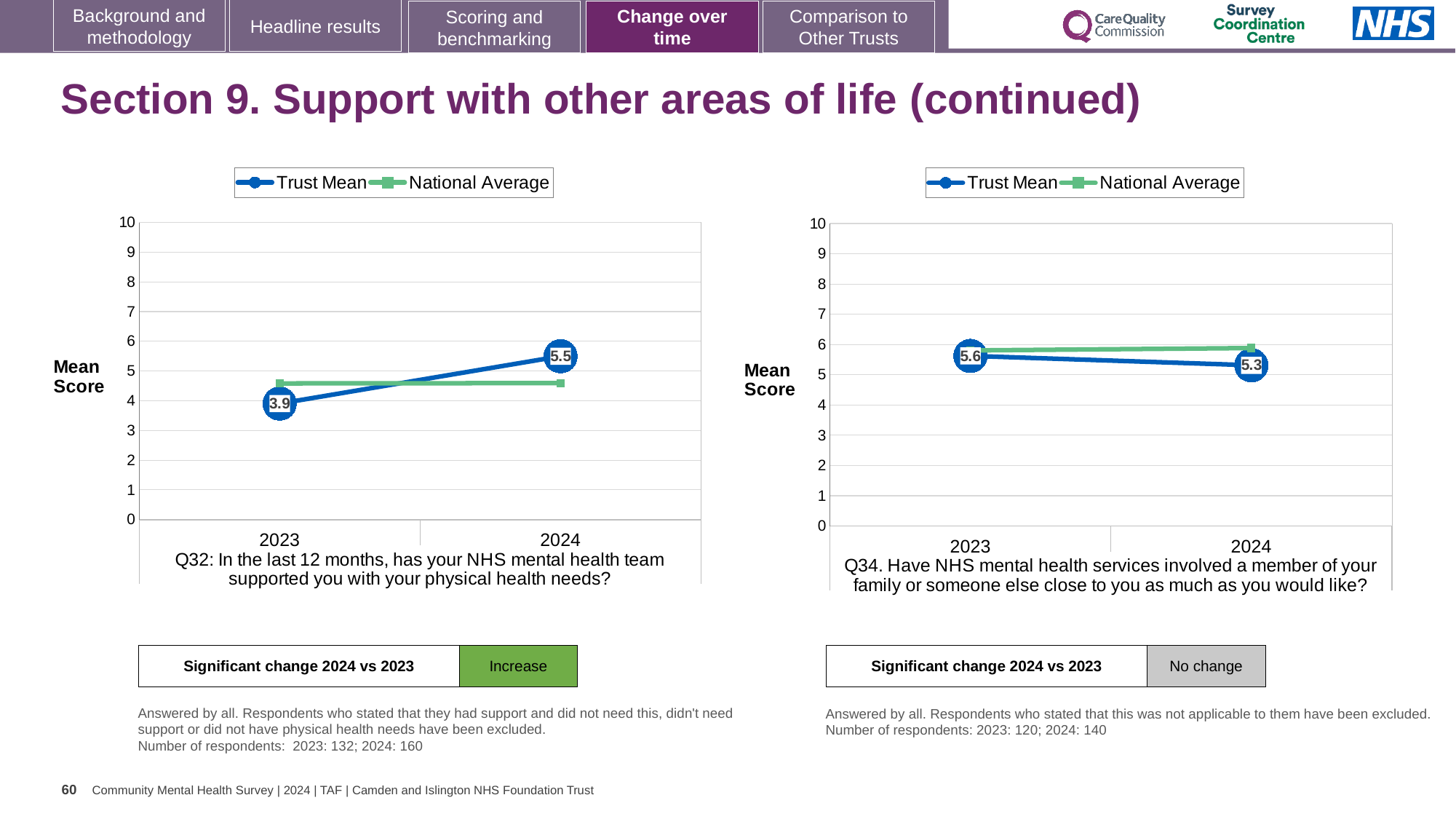
In the Q34 chart on the right, does the Trust Mean rise or fall from 2023 to 2024? fall In the Q32 chart on the left, is the Trust Mean for 2024 larger or smaller than the National Average for 2024? larger In the Q32 chart on the left, by how much did the Trust Mean change from 2023 to 2024? 1.6 How many series does the legend of the Q34 chart on the right list? 2 In the Q32 chart on the left, what is the Trust Mean score for 2023? 3.9 In the Q32 chart on the left, does the Trust Mean rise or fall from 2023 to 2024? rise What kind of chart is the Q32 chart on the left? line chart In the Q34 chart on the right, what is the Trust Mean score for 2023? 5.6 In the Q34 chart on the right, what is the Trust Mean score for 2024? 5.3 In the Q32 chart on the left, is the National Average for 2023 greater or less than 5? less In the Q34 chart on the right, what is the difference between the Trust Mean in 2023 and 2024? 0.3 In the Q32 chart on the left, what is the Trust Mean score for 2024? 5.5